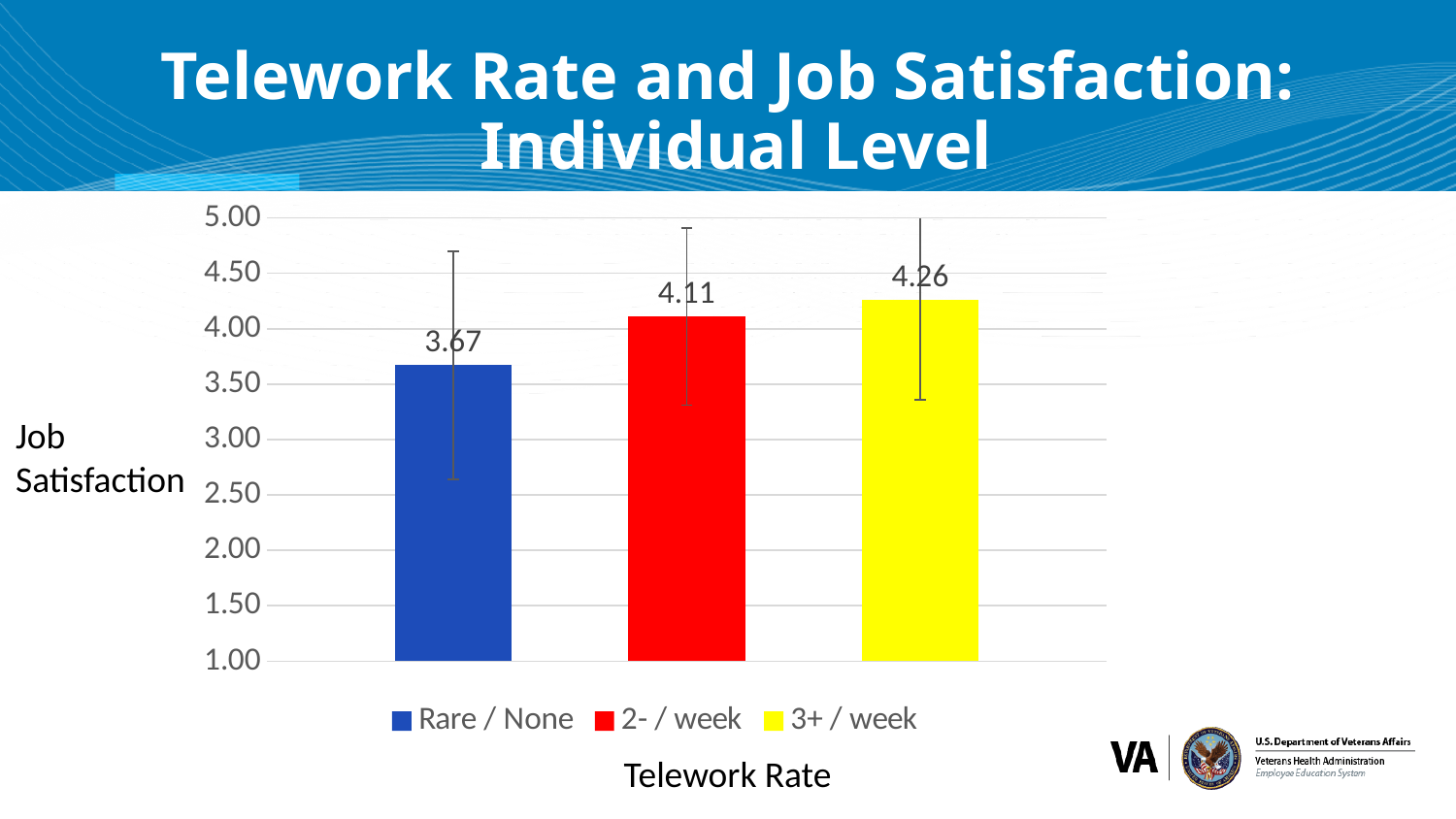
What is the job satisfaction value for the 2- / week telework rate? 4.11 What is the difference in job satisfaction between the 2- / week and Rare / None categories? 0.44 Do the job satisfaction values rise or fall as the telework rate increases from Rare / None to 3+ / week? Rise Which has a higher job satisfaction value, 2- / week or Rare / None? 2- / week Which telework rate category has the lowest job satisfaction? Rare / None Is the job satisfaction value for Rare / None greater or less than 4.00? less What is the difference in job satisfaction between the 3+ / week and Rare / None categories? 0.59 What is the job satisfaction value for the 3+ / week telework rate? 4.26 Which telework rate category has the highest job satisfaction? 3+ / week What kind of chart is shown on the slide? Bar chart How many telework rate categories are shown in the chart? 3 What is the job satisfaction value for the Rare / None telework rate? 3.67